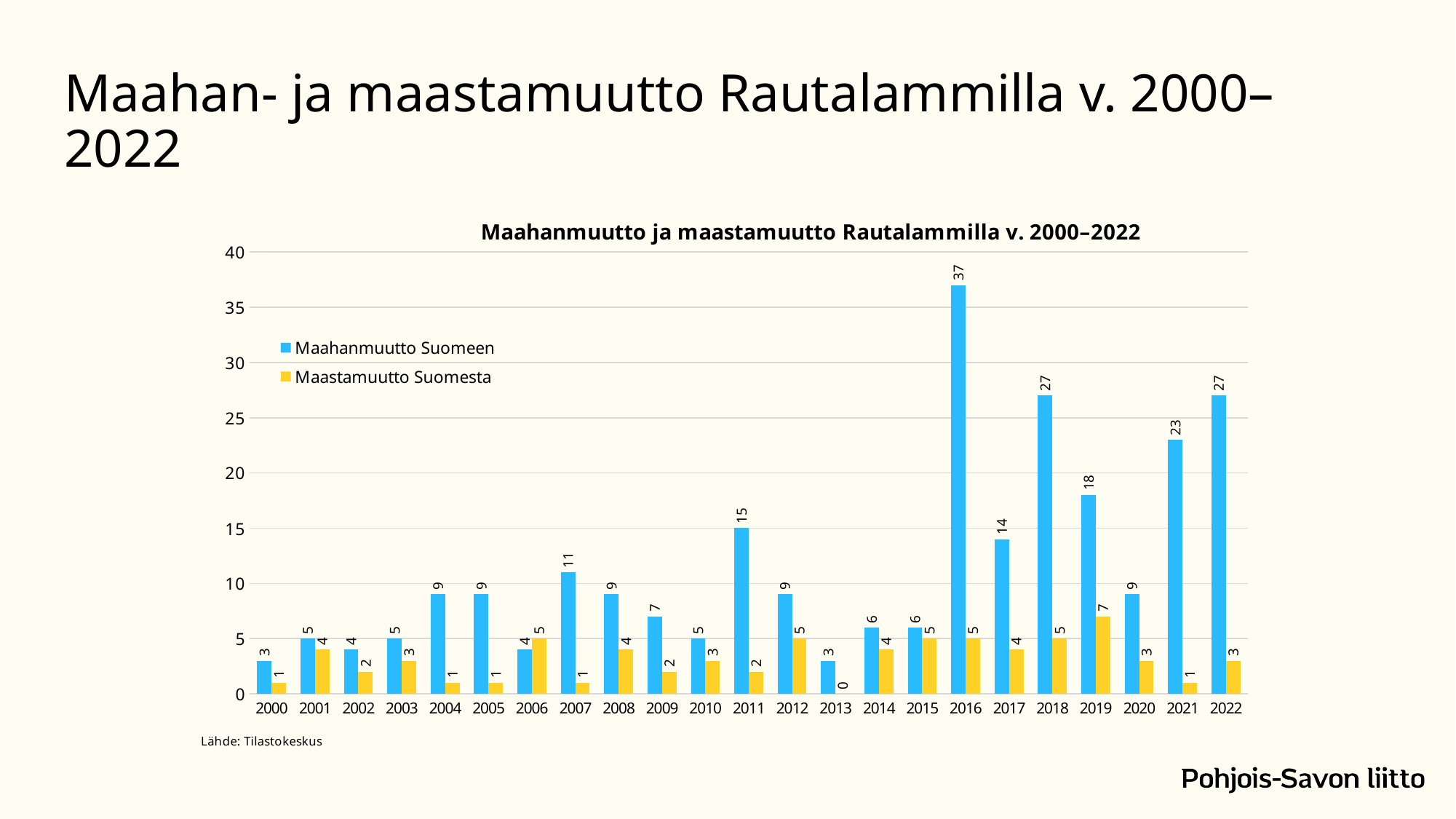
What is the value of Maahanmuutto Suomeen in 2011? 15 Which is larger in 2006, Maahanmuutto Suomeen or Maastamuutto Suomesta? Maastamuutto Suomesta In which year is Maastamuutto Suomesta highest? 2019 How many years are shown on the x axis? 23 What is the difference between Maahanmuutto Suomeen and Maastamuutto Suomesta in 2018? 22 What kind of chart is shown on the slide? Bar chart In which year is Maahanmuutto Suomeen highest? 2016 What is the value of Maastamuutto Suomesta in 2019? 7 Is the value of Maahanmuutto Suomeen in 2021 greater or less than 20? greater In which year is Maastamuutto Suomesta lowest? 2013 What is the value of Maahanmuutto Suomeen in 2016? 37 How many series does the legend list? 2